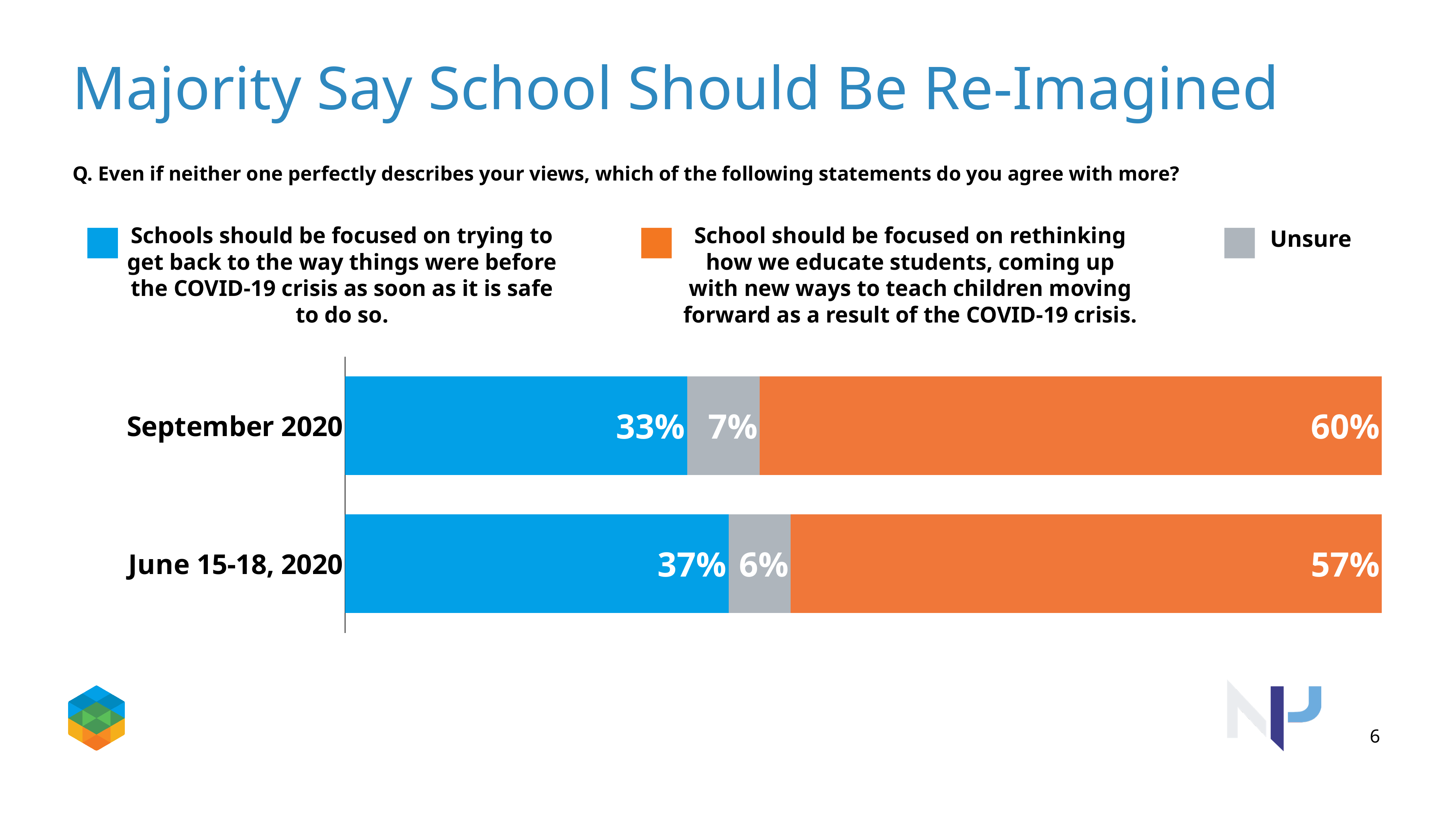
How many series does the legend list? 3 What type of chart is shown on the slide? Stacked bar chart How many survey periods are shown in the chart? 2 In September 2020, which response was chosen by the largest share of respondents? School should be focused on rethinking how we educate students By how many percentage points did the share saying school should be focused on rethinking how we educate students change from June 15-18, 2020 to September 2020? 3 percentage points Which survey period had the higher share saying schools should be focused on getting back to the way things were before the COVID-19 crisis? June 15-18, 2020 In June 15-18, 2020, which response was chosen by the smallest share of respondents? Unsure What is the difference between the share saying schools should get back to the way things were and the share saying school should be rethought in September 2020? 27 percentage points What percentage of respondents in June 15-18, 2020 said schools should be focused on getting back to the way things were before the COVID-19 crisis? 37% What percentage of respondents were unsure in September 2020? 7% What percentage of respondents were unsure in June 15-18, 2020? 6% What percentage of respondents in September 2020 said school should be focused on rethinking how we educate students? 60%